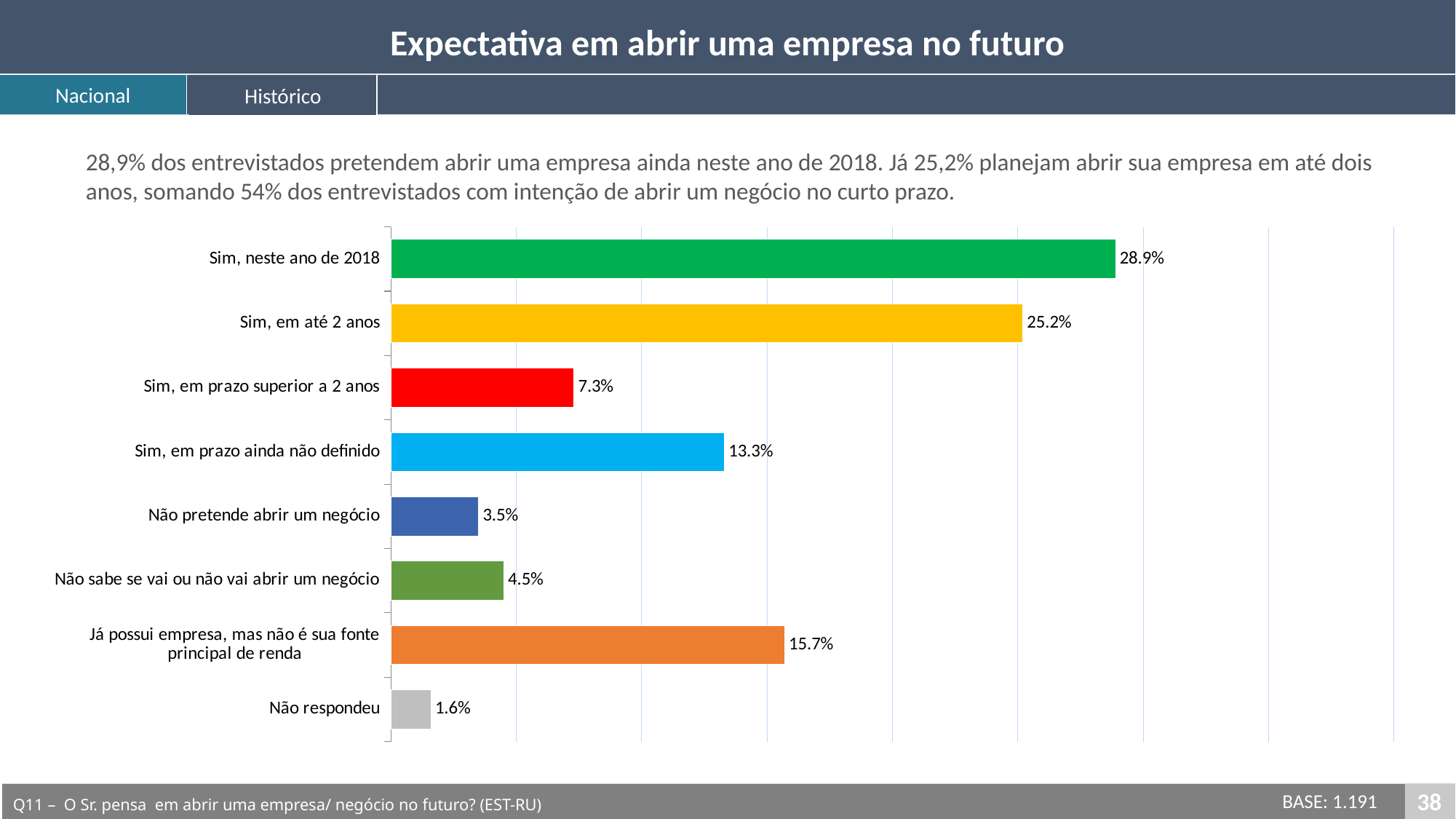
What is the value for "Não pretende abrir um negócio"? 3.5% What is the difference between "Sim, em prazo ainda não definido" and "Sim, em prazo superior a 2 anos"? 6.0% What colour is the bar for "Sim, em até 2 anos"? Yellow How many categories are shown in the chart? 8 What is the value for "Sim, neste ano de 2018"? 28.9% Which is larger: "Não sabe se vai ou não vai abrir um negócio" or "Não pretende abrir um negócio"? Não sabe se vai ou não vai abrir um negócio Which category has the highest value? Sim, neste ano de 2018 What is the value for "Já possui empresa, mas não é sua fonte principal de renda"? 15.7% Which category has the lowest value? Não respondeu What is the value for "Não respondeu"? 1.6% What is the difference between "Sim, neste ano de 2018" and "Sim, em até 2 anos"? 3.7% What kind of chart is shown on the slide? Bar chart